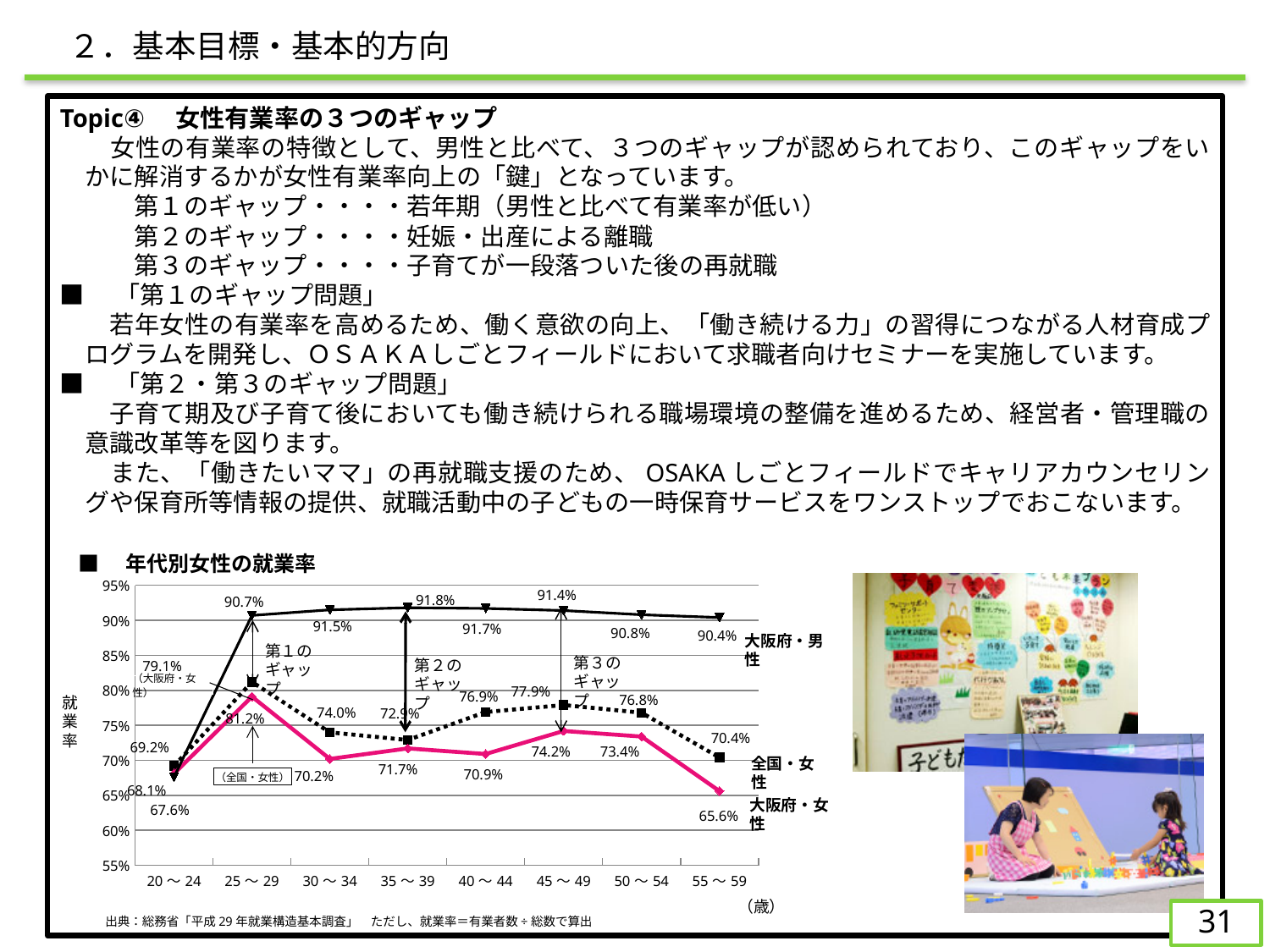
How many age groups are shown on the x axis of the chart? 8 What type of chart is shown on the slide? Line chart What is the value for 全国・女性 in the 45～49 age group? 77.9% What is the title of the chart? 年代別女性の就業率 In the 30～34 age group, which is larger: 全国・女性 or 大阪府・女性? 全国・女性 What is the value for 大阪府・女性 in the 55～59 age group? 65.6% Does the value for 大阪府・女性 rise or fall from the 25～29 age group to the 30～34 age group? Fall How many series does the chart's legend list? 3 What is the value for 全国・女性 in the 25～29 age group? 81.2% In which age group is the value for 大阪府・女性 the lowest? 55～59 What is the difference between 大阪府・男性 and 大阪府・女性 in the 35～39 age group? 20.1 percentage points What is the value for 大阪府・男性 in the 35～39 age group? 91.8%